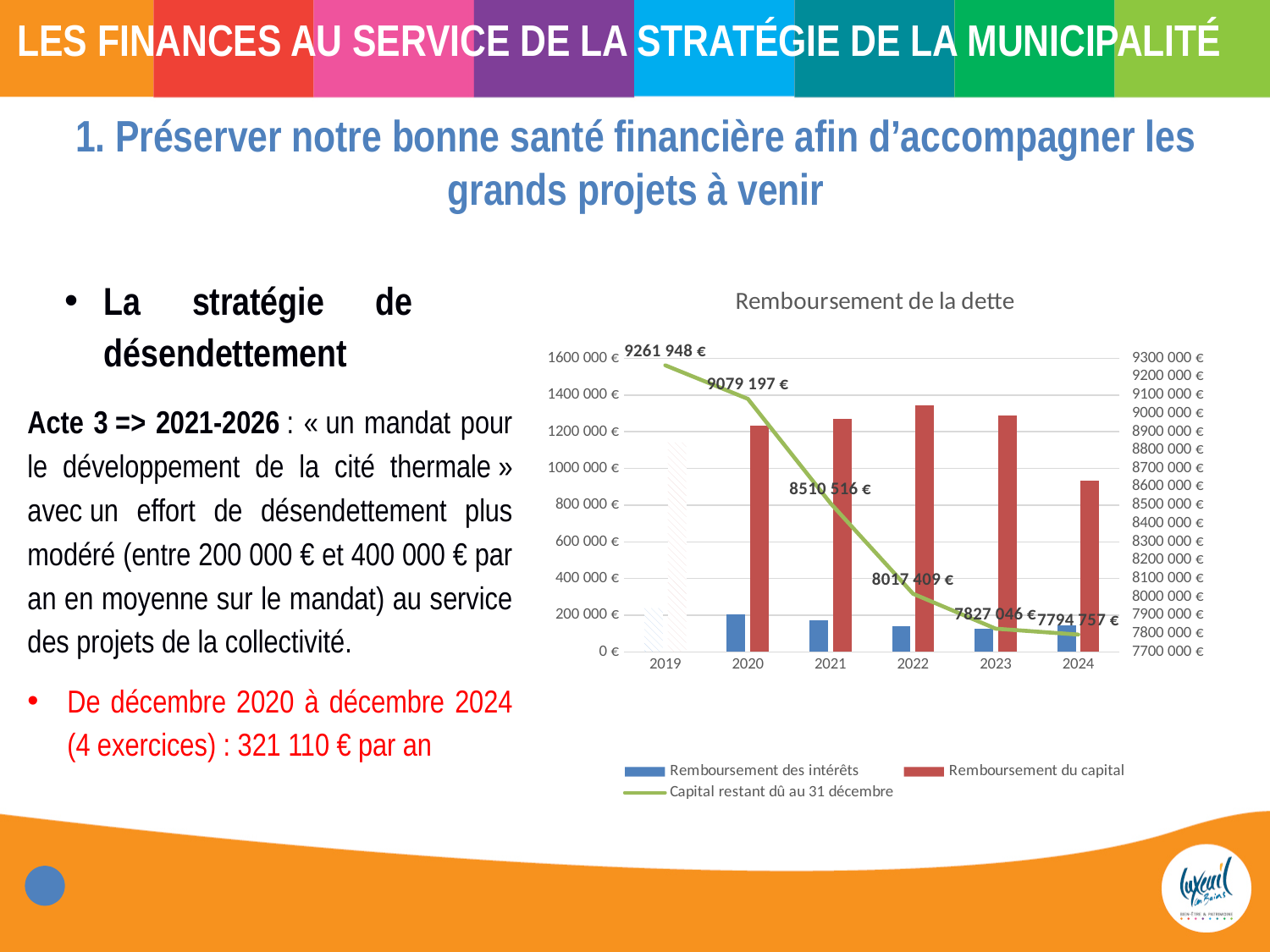
What is the value of 'Capital restant dû au 31 décembre' for 2024? 7794 757 € Which is larger in 2020: 'Remboursement des intérêts' or 'Remboursement du capital'? Remboursement du capital What is the title of the chart? Remboursement de la dette What is the value of 'Capital restant dû au 31 décembre' for 2019? 9261 948 € Is the 'Remboursement du capital' value for 2024 greater or less than 1000 000 €? less Does 'Capital restant dû au 31 décembre' rise or fall from 2019 to 2024? fall What is the value of 'Capital restant dû au 31 décembre' for 2021? 8510 516 € How many years are shown on the x axis? 6 In which year is the 'Remboursement du capital' bar the lowest? 2024 How many series does the legend list? 3 What is the difference between 'Capital restant dû au 31 décembre' in 2022 and in 2023? 190 363 € By how much did 'Capital restant dû au 31 décembre' decrease between 2019 and 2020? 182 751 €